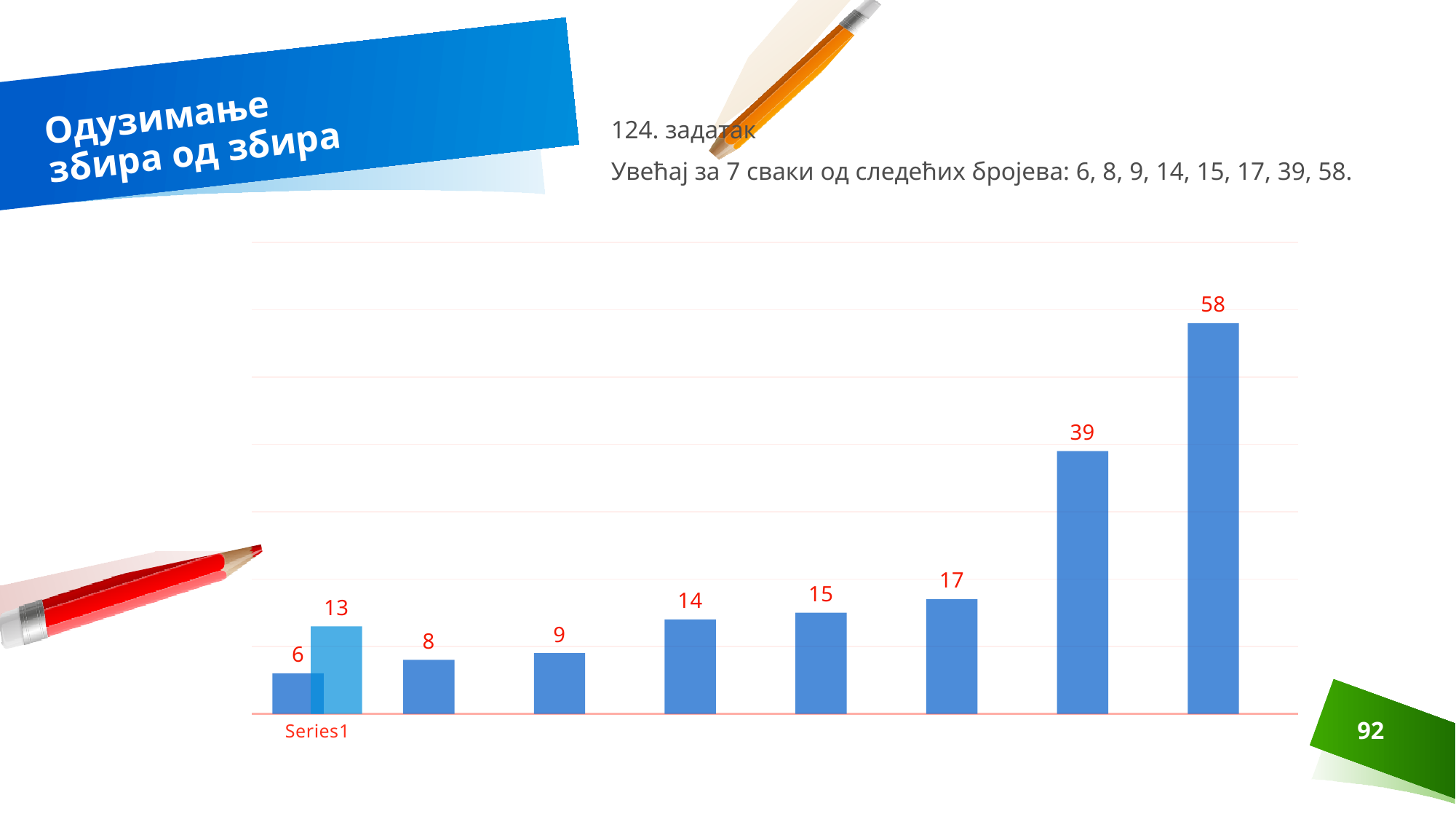
What kind of chart is shown on the slide? bar chart What value is labelled on the first dark blue bar from the left? 6 What is the difference between the bars labelled 17 and 15? 2 What is the highest value labelled on the chart? 58 What value is labelled on the light blue bar that overlaps the first dark blue bar? 13 What is the difference between the two tallest bars, labelled 58 and 39? 19 What label appears under the first bar on the x axis? Series1 What value is labelled on the second-tallest bar? 39 How many dark blue bars are plotted on the chart? 8 Which is larger, the bar labelled 39 or the bar labelled 17? 39 Do the dark blue bar values rise or fall from left to right? rise What is the lowest value labelled on the chart? 6